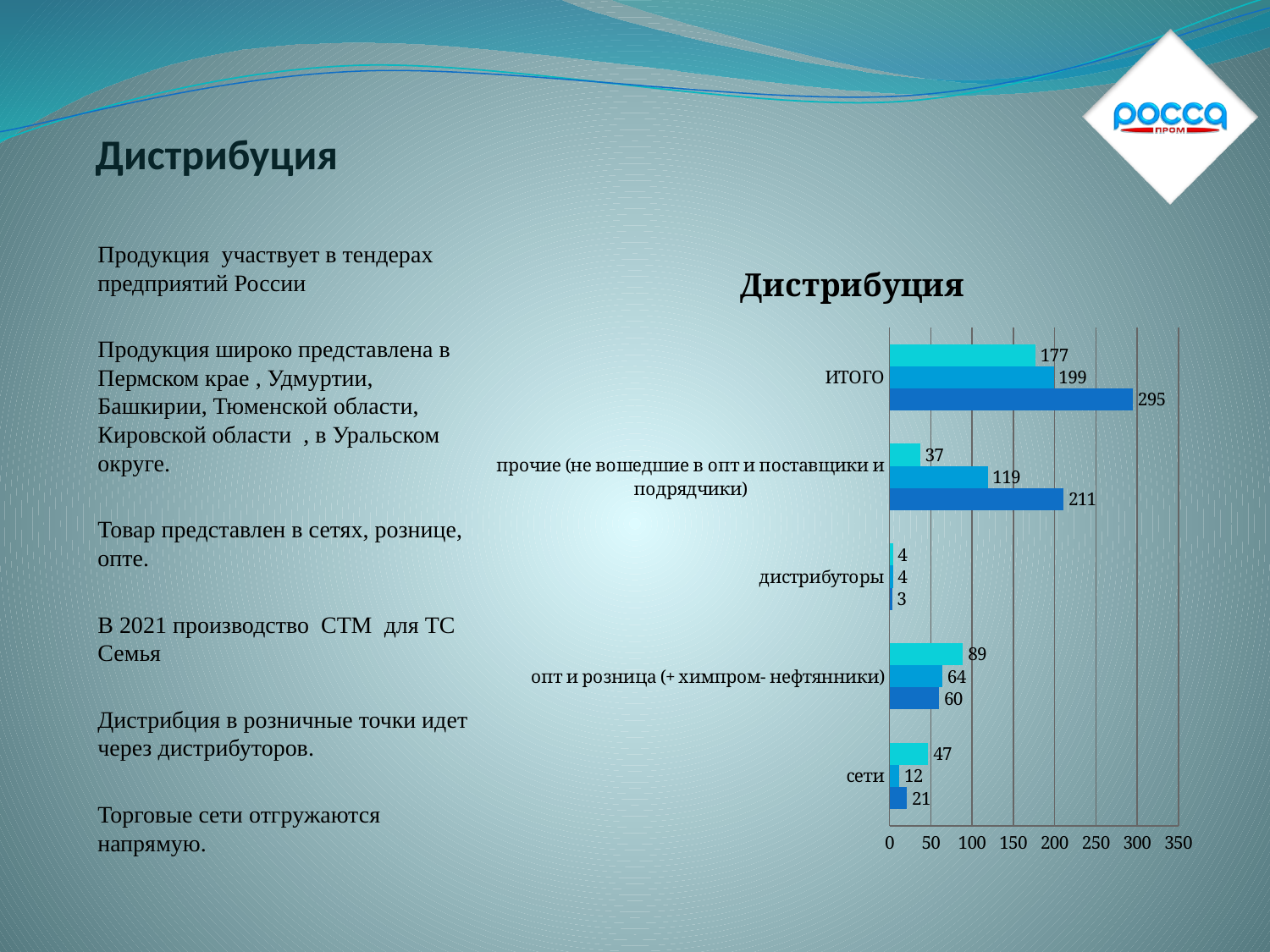
Which is larger for сети: the light cyan (top) bar or the dark blue (bottom) bar? the light cyan (top) bar What is the value of the dark blue (bottom) bar for ИТОГО? 295 What is the difference between the light cyan bar (89) and the medium blue bar (64) for опт и розница (+ химпром- нефтянники)? 25 What is the value of the middle (medium blue) bar for прочие (не вошедшие в опт и поставщики и подрядчики)? 119 What is the difference between the dark blue bar for ИТОГО (295) and the dark blue bar for прочие (211)? 84 How many categories are shown on the chart's vertical axis? 5 What kind of chart is shown on the slide? bar chart What is the title of the chart? Дистрибуция What is the value of the dark blue (bottom) bar for опт и розница (+ химпром- нефтянники)? 60 What is the value of the light cyan (top) bar for сети? 47 Which category has the lowest values across all three bars? дистрибуторы Which category has the highest dark blue (bottom) bar? ИТОГО